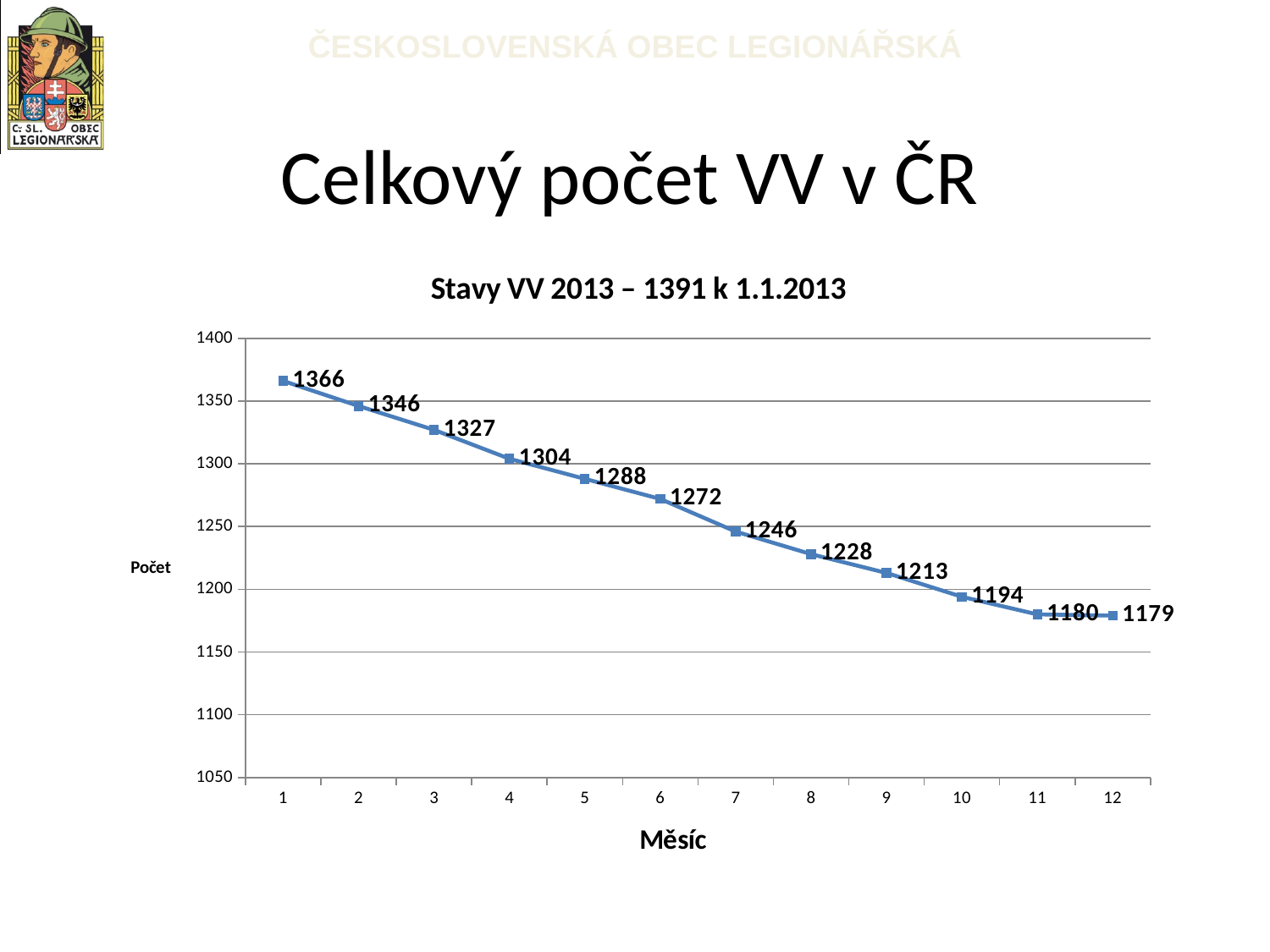
How many months are plotted on the chart? 12 Which month has the lowest value? 12 Do the values rise or fall from month 1 to month 12? fall What is the value for month 1? 1366 What kind of chart is shown? line chart What is the value for month 7? 1246 What is the difference between the values for month 4 and month 5? 16 What is the value for month 12? 1179 Which month has the highest value? 1 What is the title of the chart? Stavy VV 2013 – 1391 k 1.1.2013 Which is larger, the value for month 3 or the value for month 9? month 3 What is the difference between the values for month 1 and month 12? 187